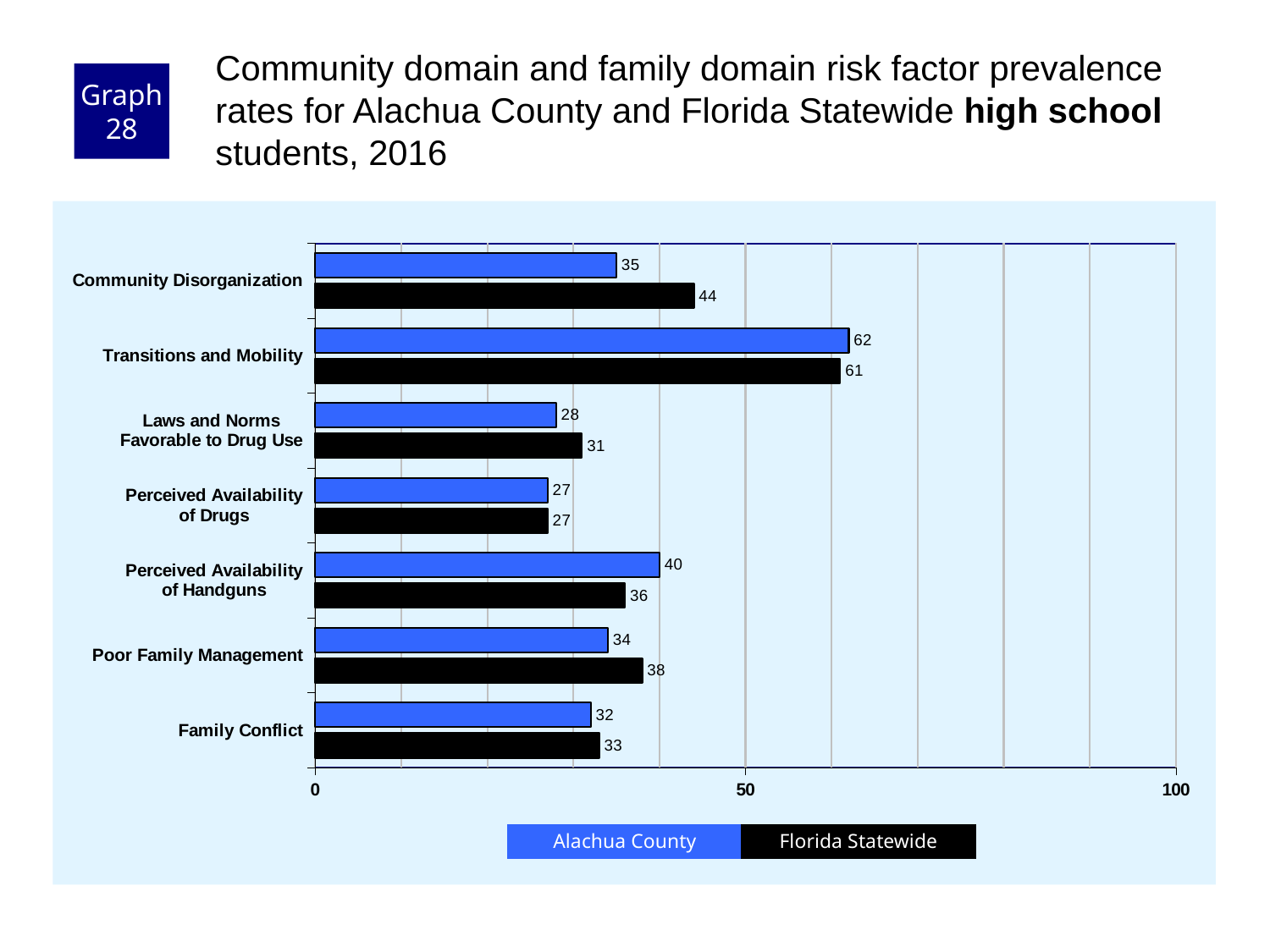
What kind of chart is shown on the slide? Bar chart For Perceived Availability of Handguns, which is larger: the Alachua County value or the Florida Statewide value? Alachua County How many series does the legend list? 2 What is the difference between the Florida Statewide and Alachua County values for Community Disorganization? 9 What is the Florida Statewide value for Poor Family Management? 38 How many risk factor categories are shown on the chart? 7 Is the Alachua County value for Transitions and Mobility greater or less than 50? greater Which risk factor has the lowest Florida Statewide value? Perceived Availability of Drugs What is the Florida Statewide value for Community Disorganization? 44 What is the Alachua County value for Transitions and Mobility? 62 Which risk factor has the highest Alachua County value? Transitions and Mobility Which colour represents Florida Statewide in the chart? Black